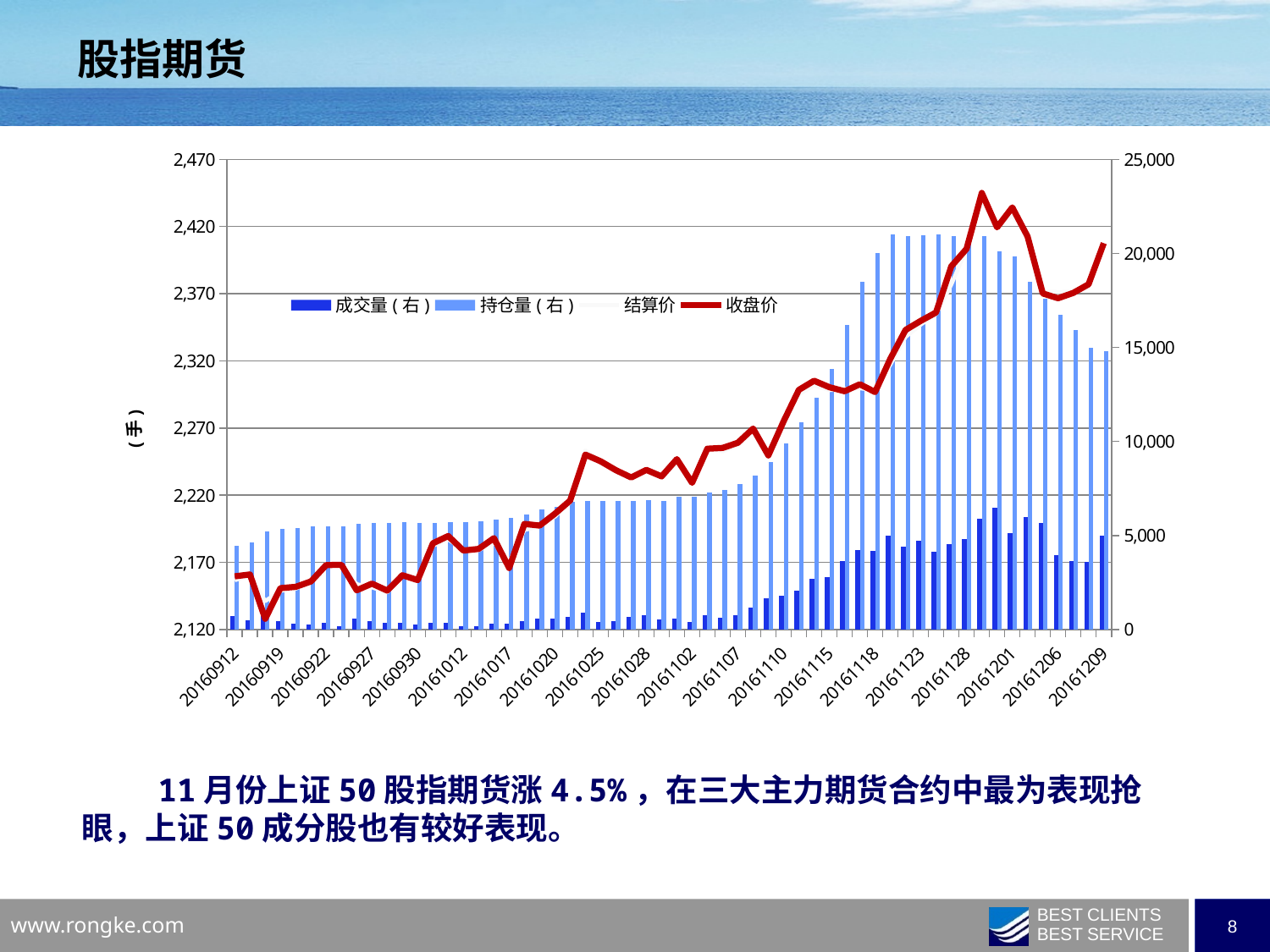
What colour is the 收盘价 line? Dark red Is the 成交量 value on 20160912 greater or less than 5,000? less Does the 收盘价 line overall rise or fall from 20160912 to 20161209? rise What kind of chart is shown on the slide? Combined bar and line chart Is the 收盘价 value on 20160912 greater or less than 2,220? less How many series does the chart legend list? 4 How many date labels are shown on the x axis? 20 Is the 持仓量 value on 20160912 greater or less than 5,000? less Which series are plotted as bars according to the legend? 成交量（右）and 持仓量（右） Which date has the larger 持仓量 value, 20160912 or 20161123? 20161123